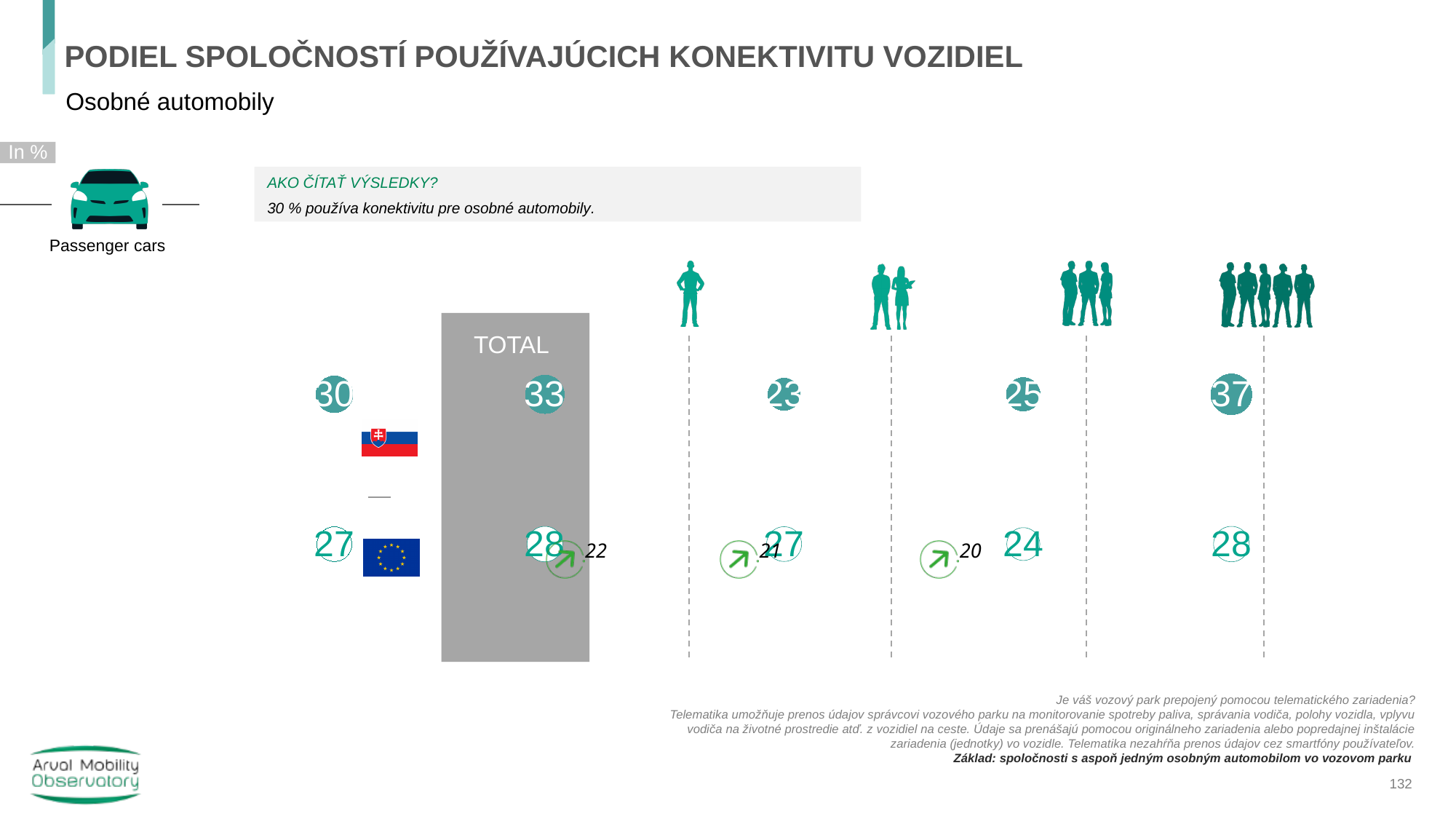
What is the lowest value shown in the top row of circles? 23 What is the subtitle of the slide below the main title? Osobné automobily What is the highest value shown in the top row of circles? 37 What is the bottom value shown in the grey TOTAL column? 28 What value is shown next to the EU flag in the bottom row? 27 In what unit are the values on the slide expressed? % What is the difference between the Slovak flag value (30) and the EU flag value (27)? 3 What value is shown next to the Slovak flag in the top row? 30 How many values are shown in the top row of circles? 5 What is the top value shown in the grey TOTAL column? 33 Which is larger: the top-row value under the three-person icon group (37) or under the two-person icon group (25)? 37